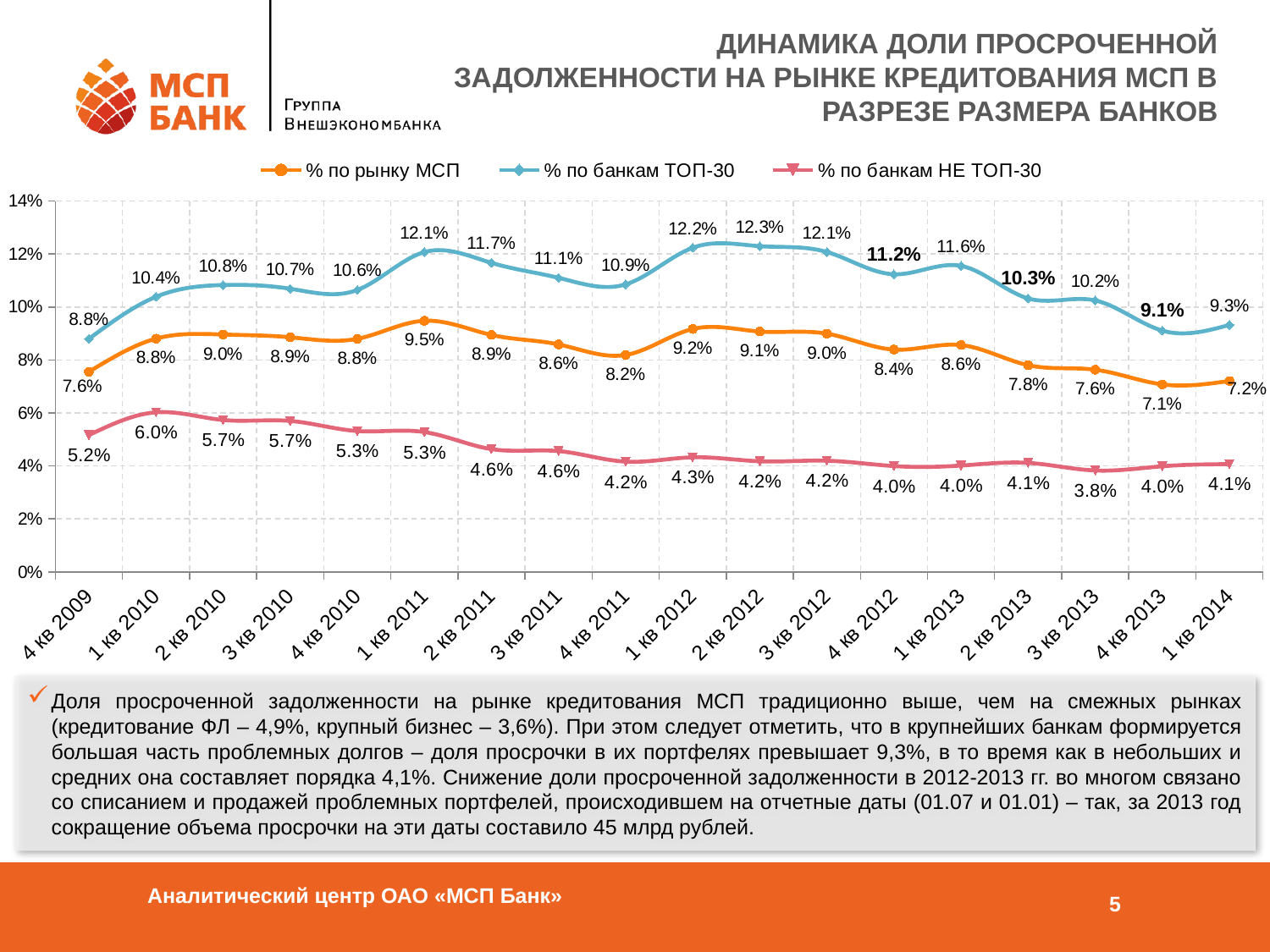
What is the difference between "% по банкам ТОП-30" and "% по банкам НЕ ТОП-30" in 1 кв 2014? 5.2% How many series does the legend list? 3 Does "% по банкам ТОП-30" rise or fall from 1 кв 2013 to 4 кв 2013? fall Which colour is used for the "% по рынку МСП" series? orange Which series has the higher value in 4 кв 2012: "% по рынку МСП" or "% по банкам ТОП-30"? % по банкам ТОП-30 In which quarter does "% по банкам ТОП-30" reach its highest value? 2 кв 2012 In which quarter does "% по банкам НЕ ТОП-30" reach its lowest value? 3 кв 2013 What type of chart is shown on the slide? line chart How many quarters (points) are shown along the x axis? 18 What is the value for "% по рынку МСП" in 4 кв 2013? 7.1% What is the value for "% по банкам ТОП-30" in 1 кв 2011? 12.1% What is the value for "% по банкам НЕ ТОП-30" in 1 кв 2010? 6.0%